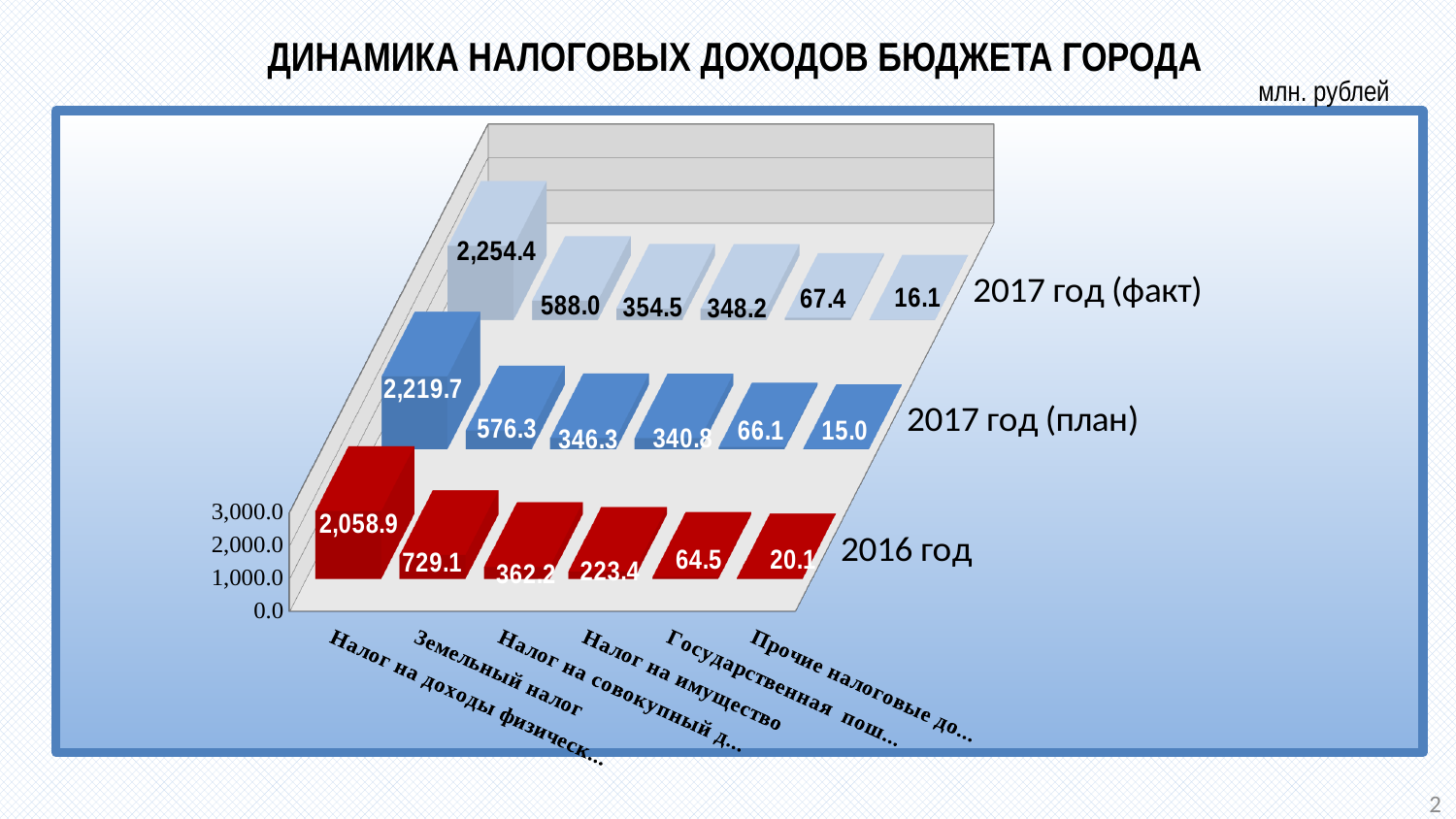
Which series has the highest value for Земельный налог? 2016 год How many tax categories are shown on the chart? 6 What unit of measurement is indicated for the chart? млн. рублей What is the value for Земельный налог in the 2016 год series? 729.1 Which is larger for Налог на имущество: the 2016 год value or the 2017 год (факт) value? 2017 год (факт) What is the difference between the 2016 год and 2017 год (факт) values for Земельный налог? 141.1 What is the value for Налог на имущество in the 2017 год (факт) series? 348.2 What is the value for Государственная пошлина in the 2017 год (план) series? 66.1 What is the smallest value shown in the 2017 год (план) series? 15.0 What is the value for Земельный налог in the 2017 год (факт) series? 588.0 What is the difference between the 2017 год (факт) and 2017 год (план) values for the first category (Налог на доходы физических лиц)? 34.7 How many series does the chart show? 3